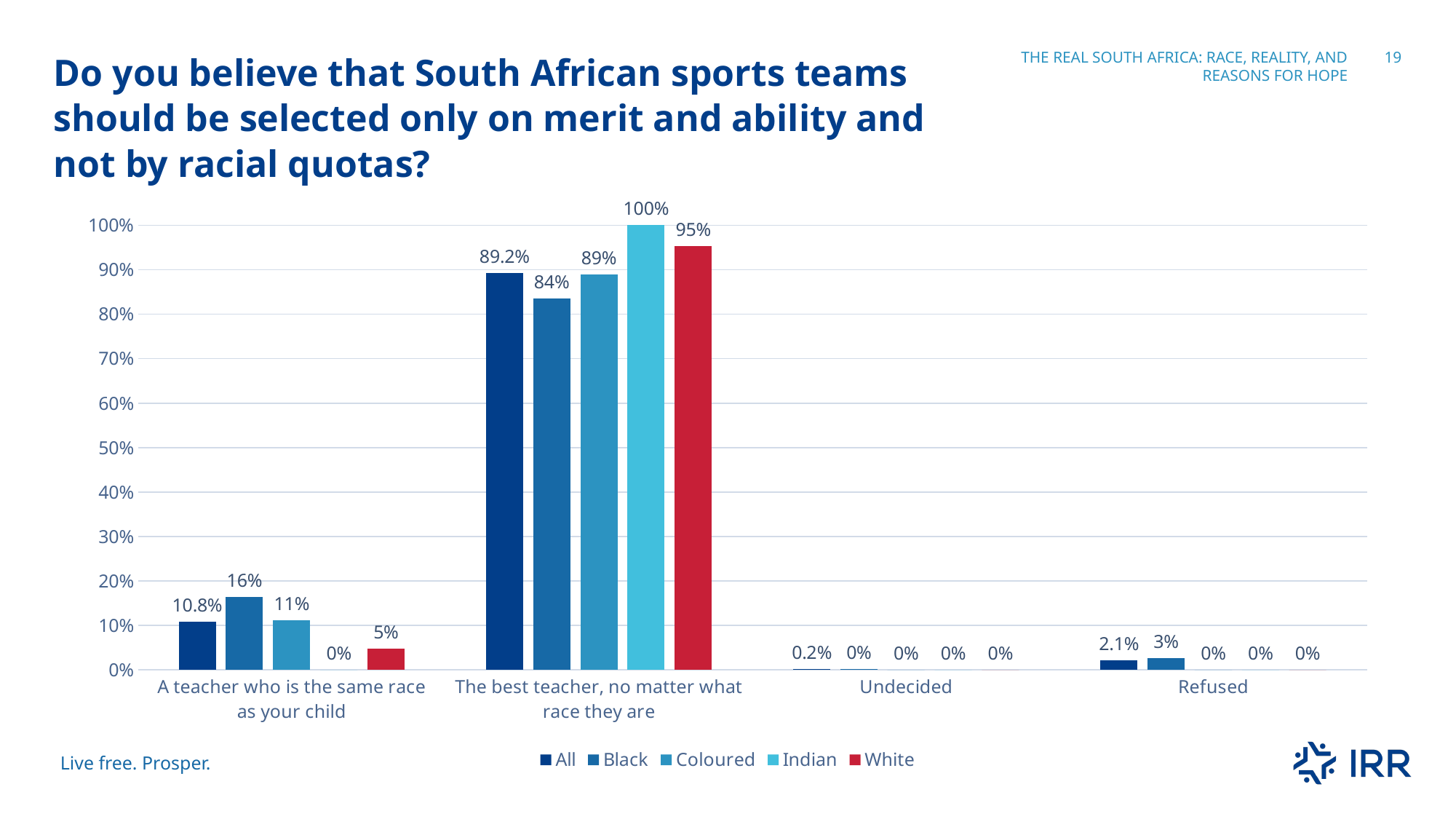
What is the value for Black in the 'Refused' category? 3% What is the difference between the White and Black values in the 'The best teacher, no matter what race they are' category? 11% Which series has the highest value in the 'The best teacher, no matter what race they are' category? Indian What is the value for All in the 'A teacher who is the same race as your child' category? 10.8% What is the value for Indian in the 'The best teacher, no matter what race they are' category? 100% What colour are the bars for the White series? Red How many series does the legend list? 5 In the 'A teacher who is the same race as your child' category, which is larger: the Black value or the Coloured value? Black What is the value for White in the 'A teacher who is the same race as your child' category? 5% How many categories are shown on the x axis? 4 Which series has the lowest value in the 'A teacher who is the same race as your child' category? Indian What kind of chart is shown on the slide? Bar chart